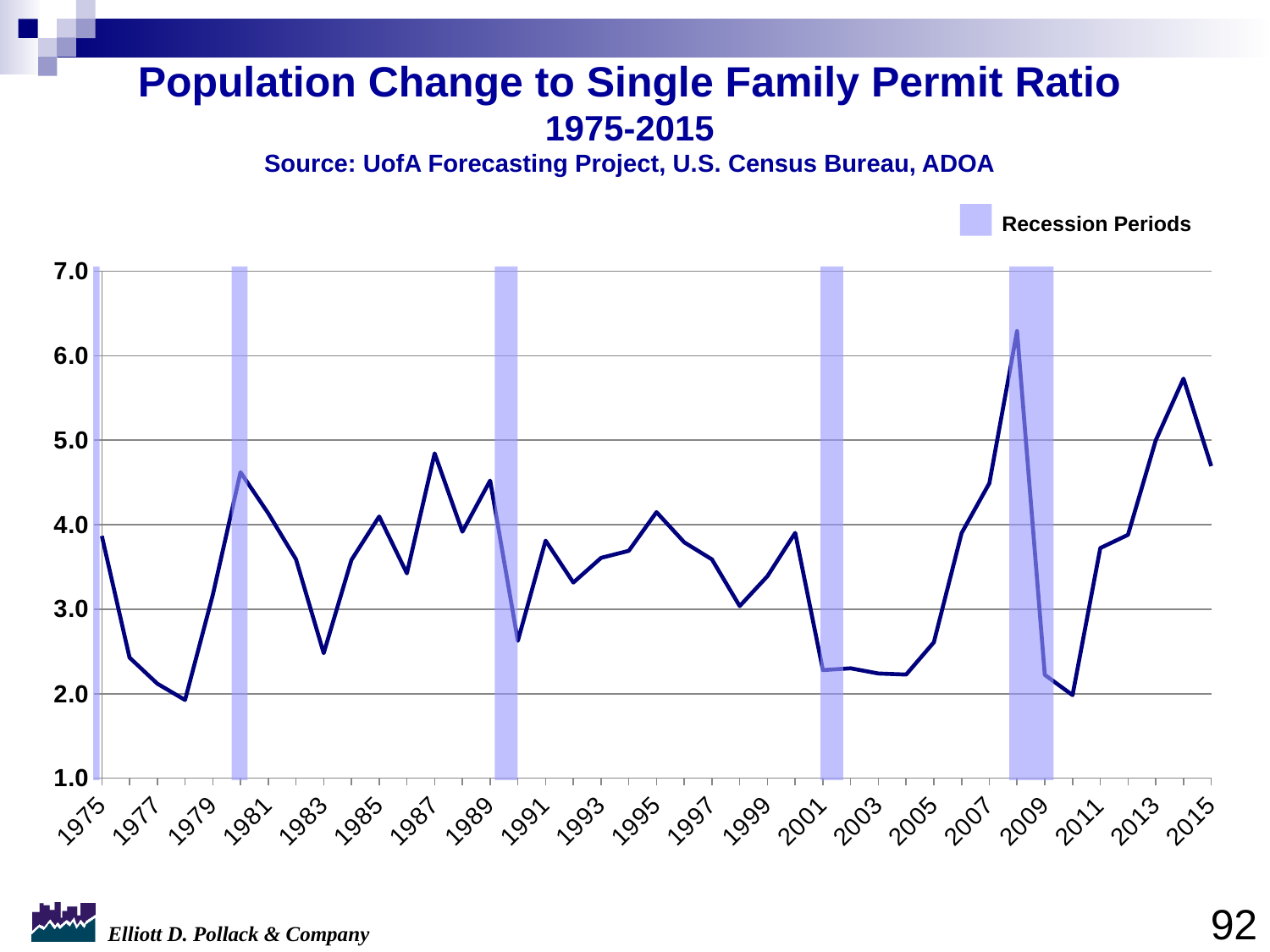
Is the value for 2008 greater or less than 6.0? greater In which year does the ratio reach its highest value? 2008 Which year has the larger value, 2008 or 2014? 2008 What do the shaded vertical bands on the chart represent, according to the legend? Recession Periods Which year has the larger value, 1980 or 1983? 1980 Does the ratio rise or fall between 2010 and 2014? rise What kind of chart is shown on the slide? line chart Is the value for 2001 greater or less than 3.0? less Is the value for 2014 greater or less than 5.0? greater What is the title of the chart? Population Change to Single Family Permit Ratio